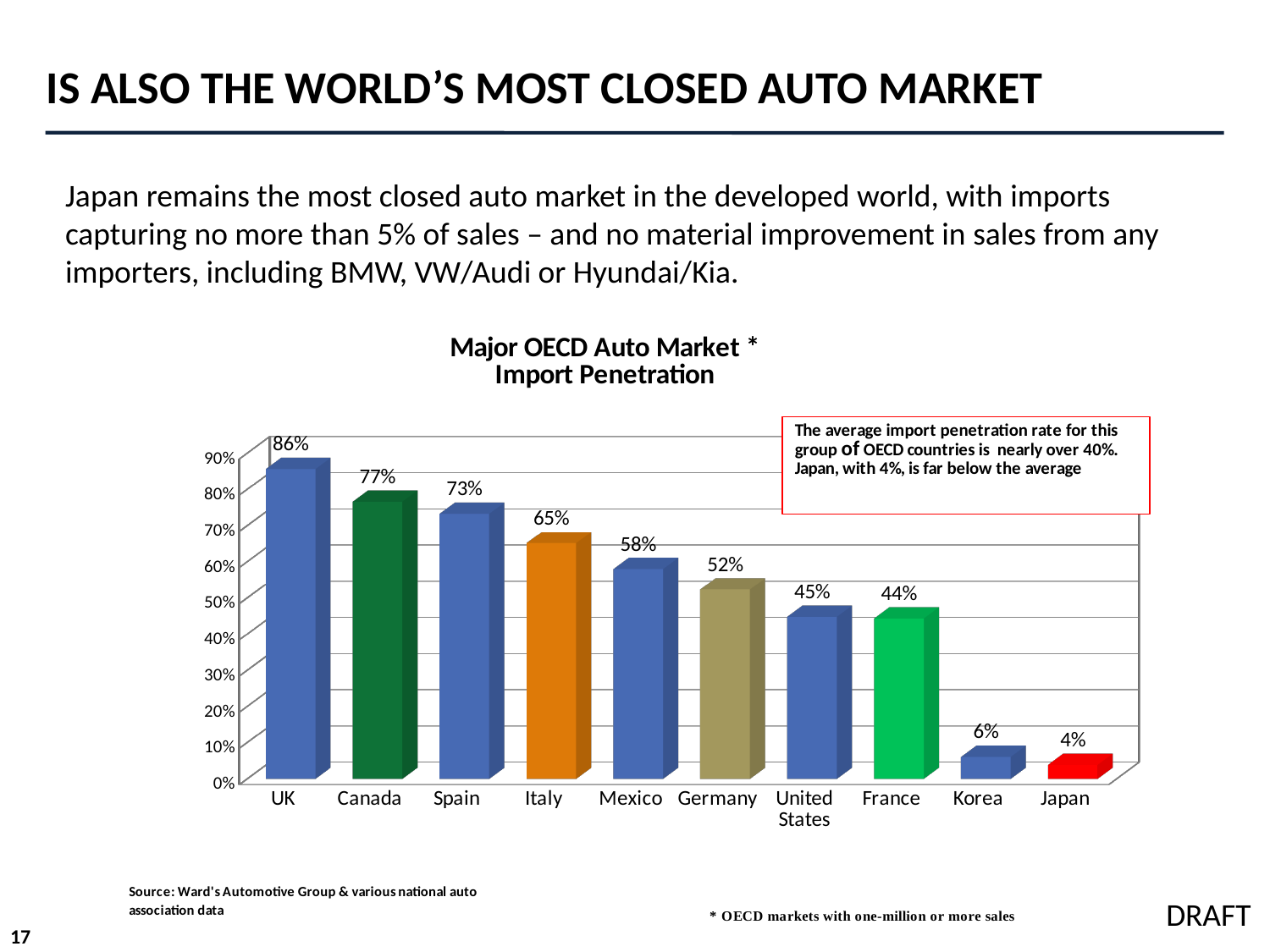
Which country has the highest import penetration? UK How many countries are shown in the chart? 10 What is the import penetration value for Germany? 52% What is the title of the chart? Major OECD Auto Market * Import Penetration Which country has the lowest import penetration? Japan What is the import penetration value for Canada? 77% What is the import penetration value for Japan? 4% What is the difference between the import penetration of the UK and Japan? 82% What is the difference between the import penetration of Spain and Italy? 8% What kind of chart is shown on the slide? Bar chart Which has a higher import penetration, Mexico or France? Mexico Do the values rise or fall from left to right across the countries? Fall